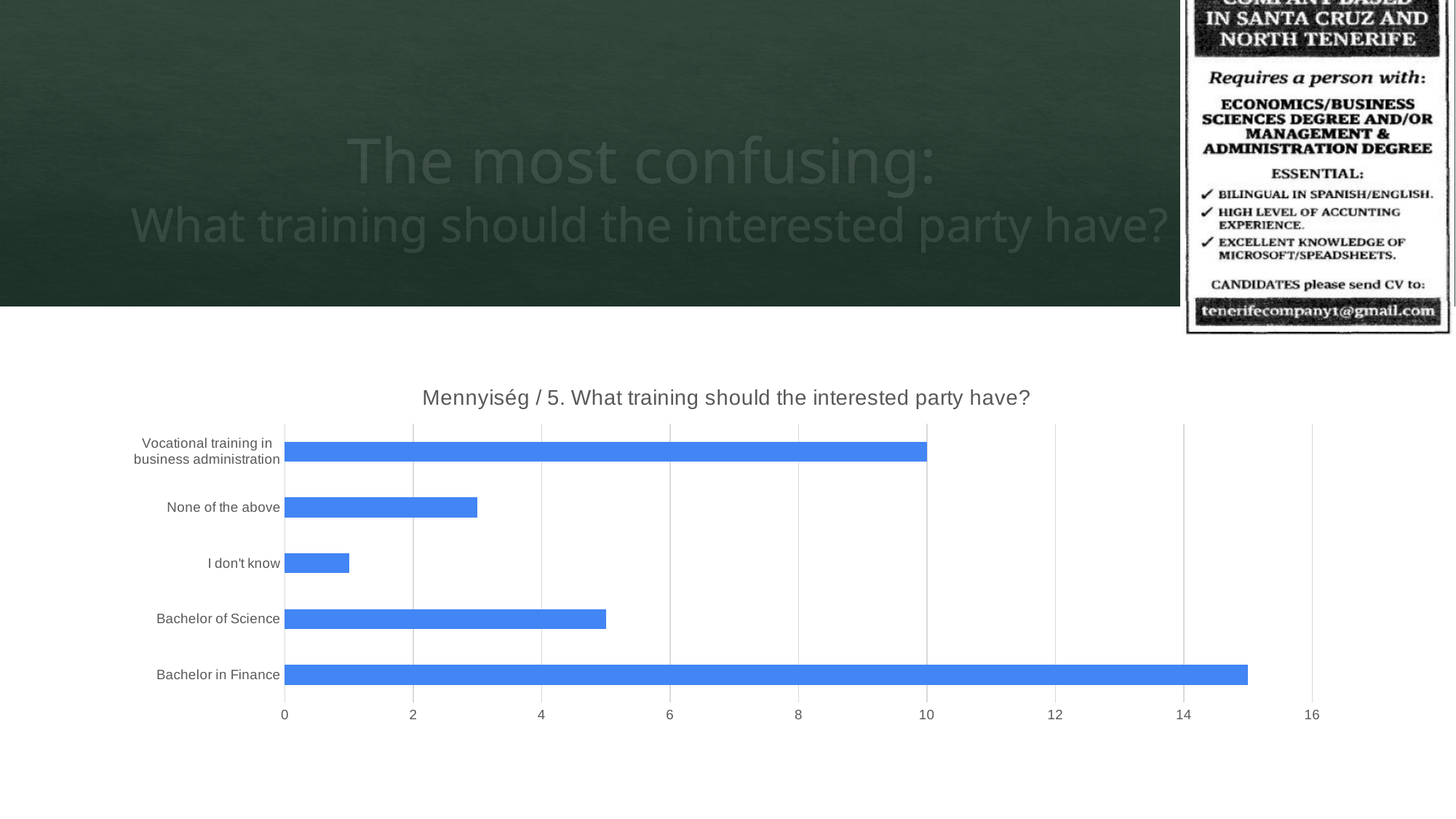
What type of chart is shown on the slide? bar chart Is the value for Bachelor of Science greater or less than 4? greater What is the value for Vocational training in business administration? 10 Is the value for Bachelor in Finance greater or less than 14? greater How many categories are shown in the chart? 5 What colour are the bars in the chart? blue Is the value for I don't know greater or less than 2? less Which category has the highest value? Bachelor in Finance What is the title of the chart? Mennyiség / 5. What training should the interested party have? Which category has the lowest value? I don't know Which has a larger value, Bachelor of Science or None of the above? Bachelor of Science